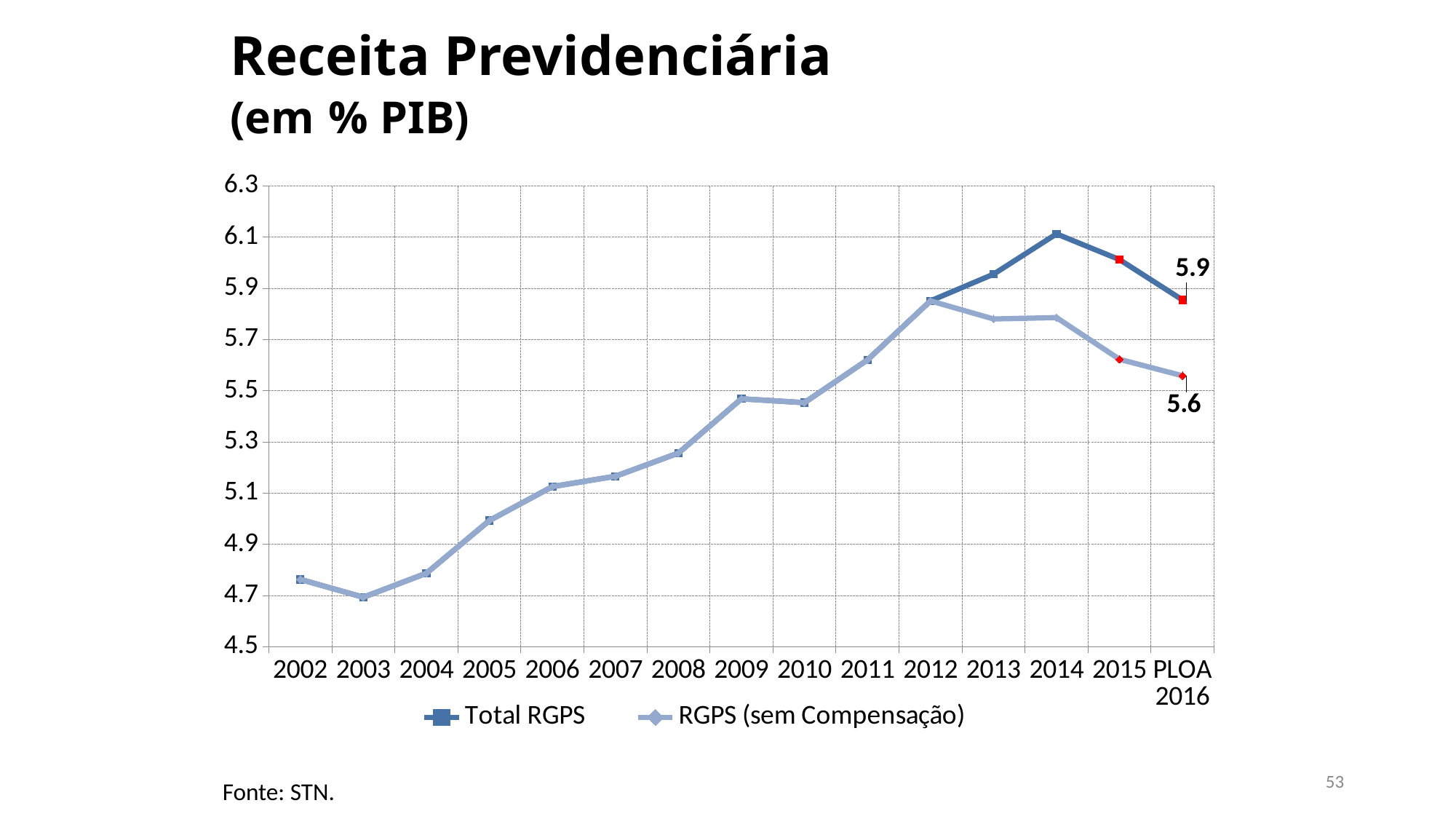
What is the value of Total RGPS for PLOA 2016? 5.9 In which year does the Total RGPS series reach its highest value? 2014 What is the difference between Total RGPS and RGPS (sem Compensação) for PLOA 2016? 0.3 How many series does the legend list? 2 What is the value of RGPS (sem Compensação) for PLOA 2016? 5.6 Is the value for Total RGPS in 2005 greater or less than 5.1? less How many categories are shown on the x axis? 15 For PLOA 2016, which series has the larger value, Total RGPS or RGPS (sem Compensação)? Total RGPS Does the Total RGPS series rise or fall from 2003 to 2014? Rise In which year is the Total RGPS series at its lowest value? 2003 What kind of chart is shown on the slide? Line chart Is the value for Total RGPS in 2011 greater or less than 5.5? greater